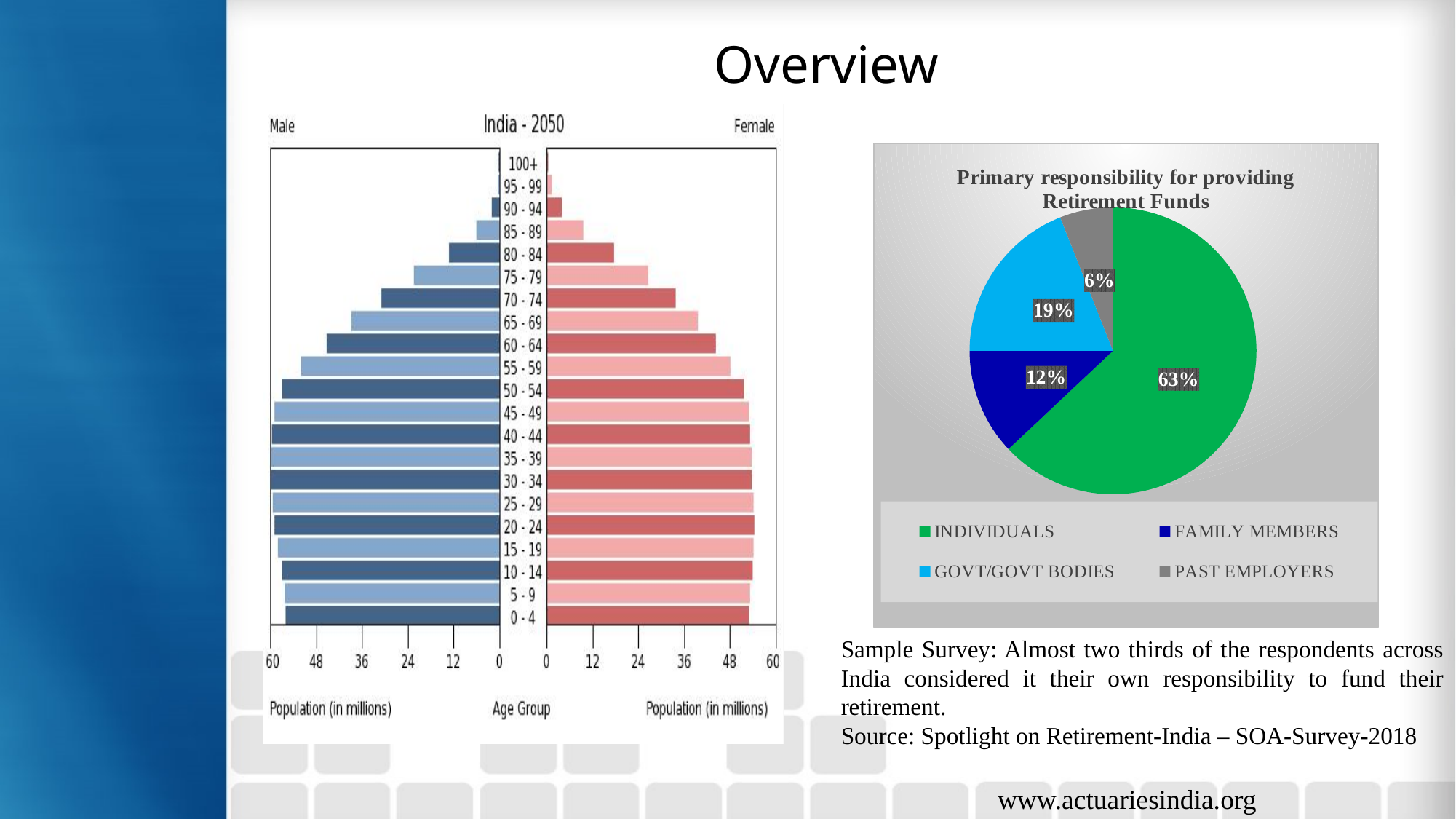
In the pie chart titled 'Primary responsibility for providing Retirement Funds', which is larger: FAMILY MEMBERS or PAST EMPLOYERS? FAMILY MEMBERS What kind of chart is the 'India - 2050' chart on the left of the slide? Bar chart How many categories does the legend of the pie chart titled 'Primary responsibility for providing Retirement Funds' list? 4 In the pie chart titled 'Primary responsibility for providing Retirement Funds', which category has the smallest slice? PAST EMPLOYERS In the 'India - 2050' chart on the left, is the Male population for the 0 - 4 age group greater or less than 48 million? greater In the pie chart titled 'Primary responsibility for providing Retirement Funds', what share is attributed to FAMILY MEMBERS? 12% In the pie chart titled 'Primary responsibility for providing Retirement Funds', which category has the largest slice? INDIVIDUALS How many age groups are shown on the 'India - 2050' chart on the left? 21 In the pie chart titled 'Primary responsibility for providing Retirement Funds', what is the difference in percentage points between INDIVIDUALS and GOVT/GOVT BODIES? 44 In the 'India - 2050' chart on the left, is the Male population for the 90 - 94 age group greater or less than 12 million? less In the pie chart titled 'Primary responsibility for providing Retirement Funds', what share is attributed to INDIVIDUALS? 63% In the pie chart titled 'Primary responsibility for providing Retirement Funds', what share is attributed to GOVT/GOVT BODIES? 19%